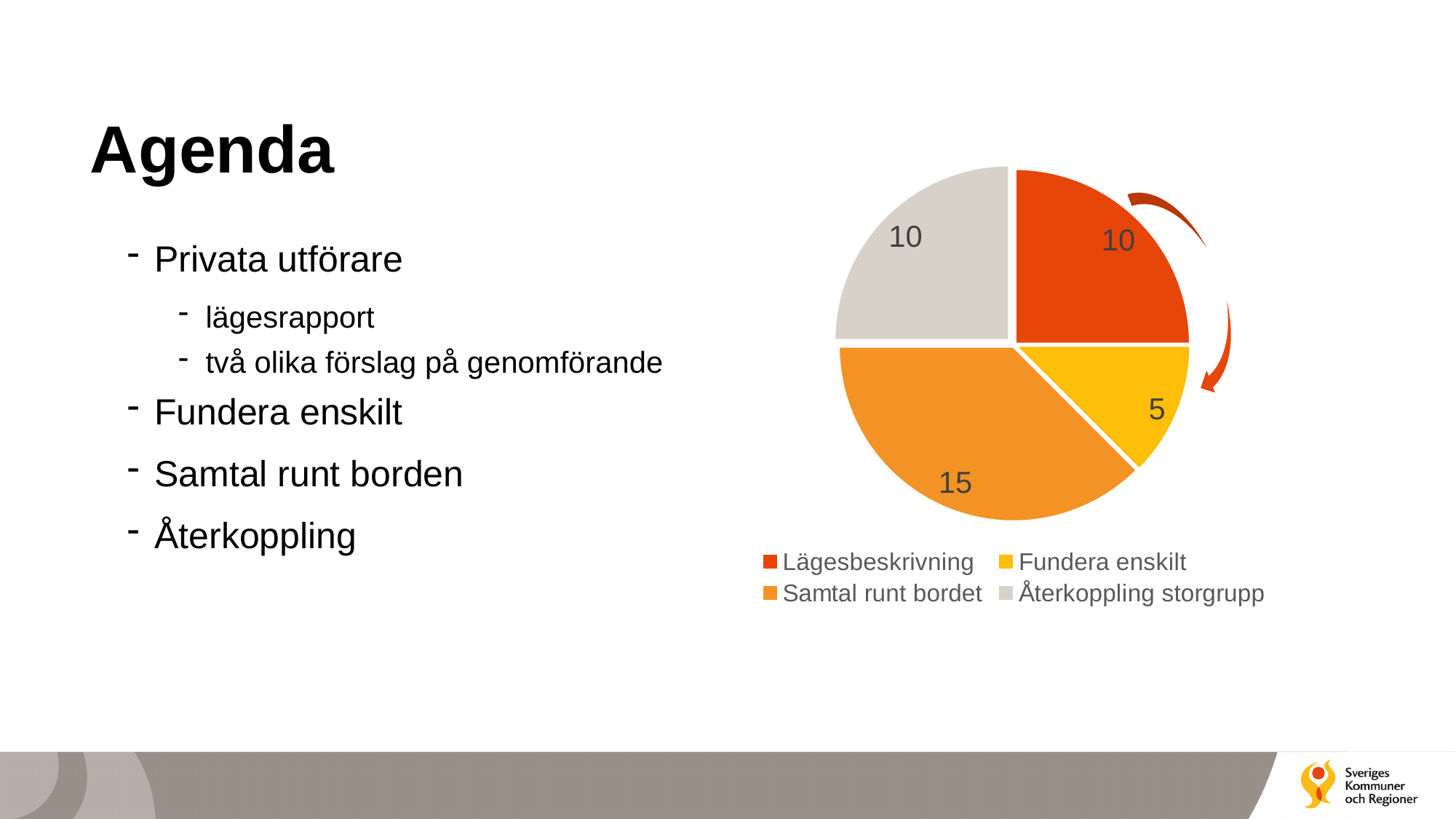
What kind of chart is shown on the slide? Pie chart Which category has the smallest slice in the pie chart? Fundera enskilt What is the value for Lägesbeskrivning in the pie chart? 10 How many slices does the pie chart have? 4 What is the difference between the values for Samtal runt bordet and Fundera enskilt? 10 Which category has the largest slice in the pie chart? Samtal runt bordet What colour is the Fundera enskilt slice in the pie chart? Yellow What is the value for Fundera enskilt in the pie chart? 5 What share of the pie does Samtal runt bordet represent? 37.5% Which is larger, the value for Lägesbeskrivning or the value for Fundera enskilt? Lägesbeskrivning What is the value for Samtal runt bordet in the pie chart? 15 What is the value for Återkoppling storgrupp in the pie chart? 10